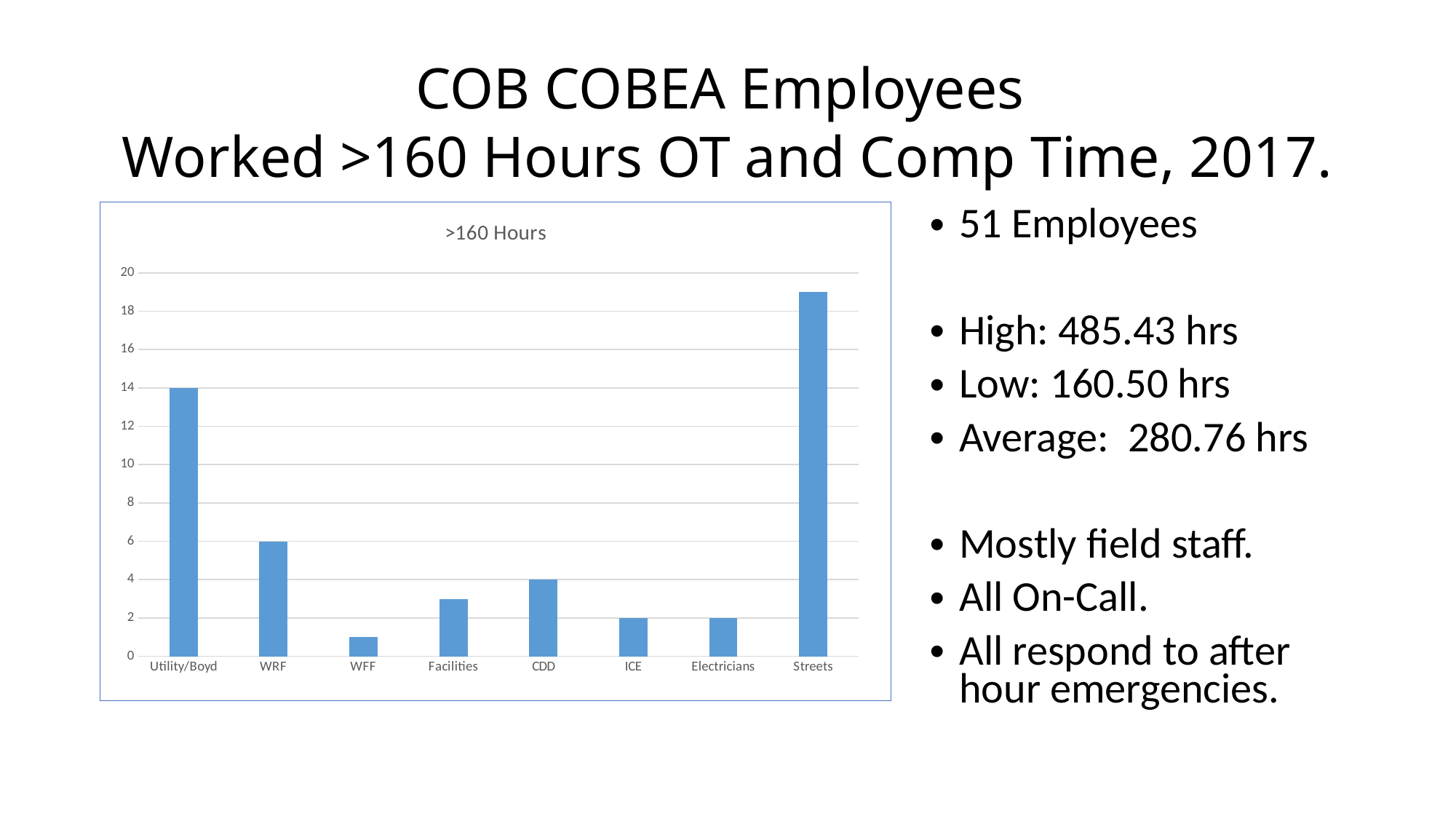
Which category has the lowest bar in the chart? WFF What is the value for Utility/Boyd in the chart? 14 What is the value for ICE in the chart? 2 What is the value for CDD in the chart? 4 Is the value for Streets greater or less than 18? greater How many categories are shown on the x axis of the chart? 8 What is the title of the chart? >160 Hours Which category has the highest bar in the chart? Streets Which is larger, the value for Facilities or the value for CDD? CDD What type of chart is shown on the slide? bar chart What is the value for WRF in the chart? 6 What is the difference between the values for Utility/Boyd and WRF? 8